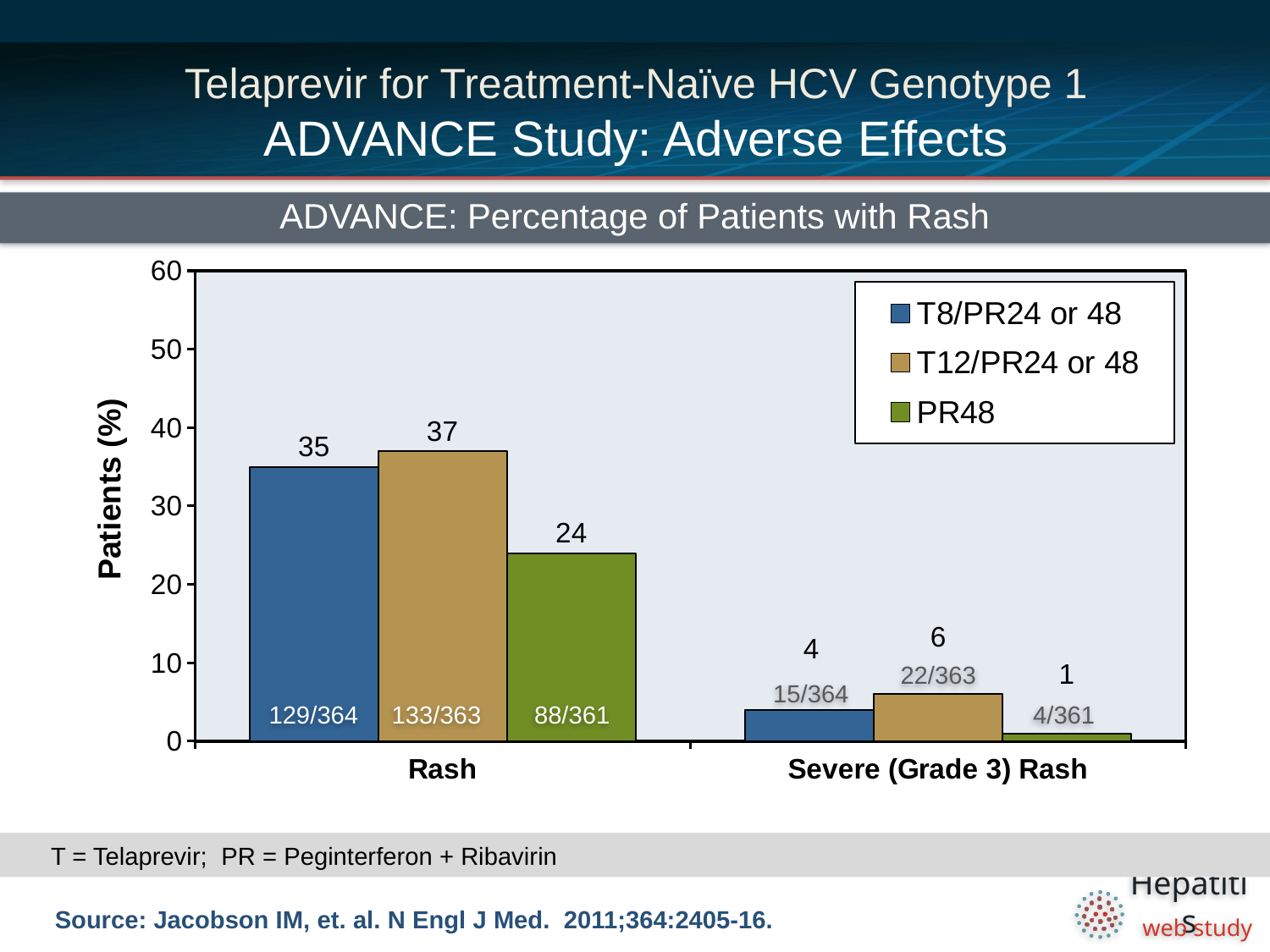
What is the title of the chart? ADVANCE: Percentage of Patients with Rash What percentage of patients in the T8/PR24 or 48 group had a rash? 35 What percentage of patients in the PR48 group had a severe (Grade 3) rash? 1 Which is larger: the severe (Grade 3) rash percentage for T8/PR24 or 48 or for T12/PR24 or 48? T12/PR24 or 48 What kind of chart is shown on the slide? Bar chart How many treatment groups does the legend list? 3 What is the fraction label shown on the PR48 bar for rash? 88/361 What percentage of patients in the T12/PR24 or 48 group had a rash? 37 What is the difference in rash percentage between the T12/PR24 or 48 group and the PR48 group? 13 Which treatment group had the lowest percentage of patients with severe (Grade 3) rash? PR48 Which treatment group had the highest percentage of patients with rash? T12/PR24 or 48 How many categories are shown on the x axis? 2